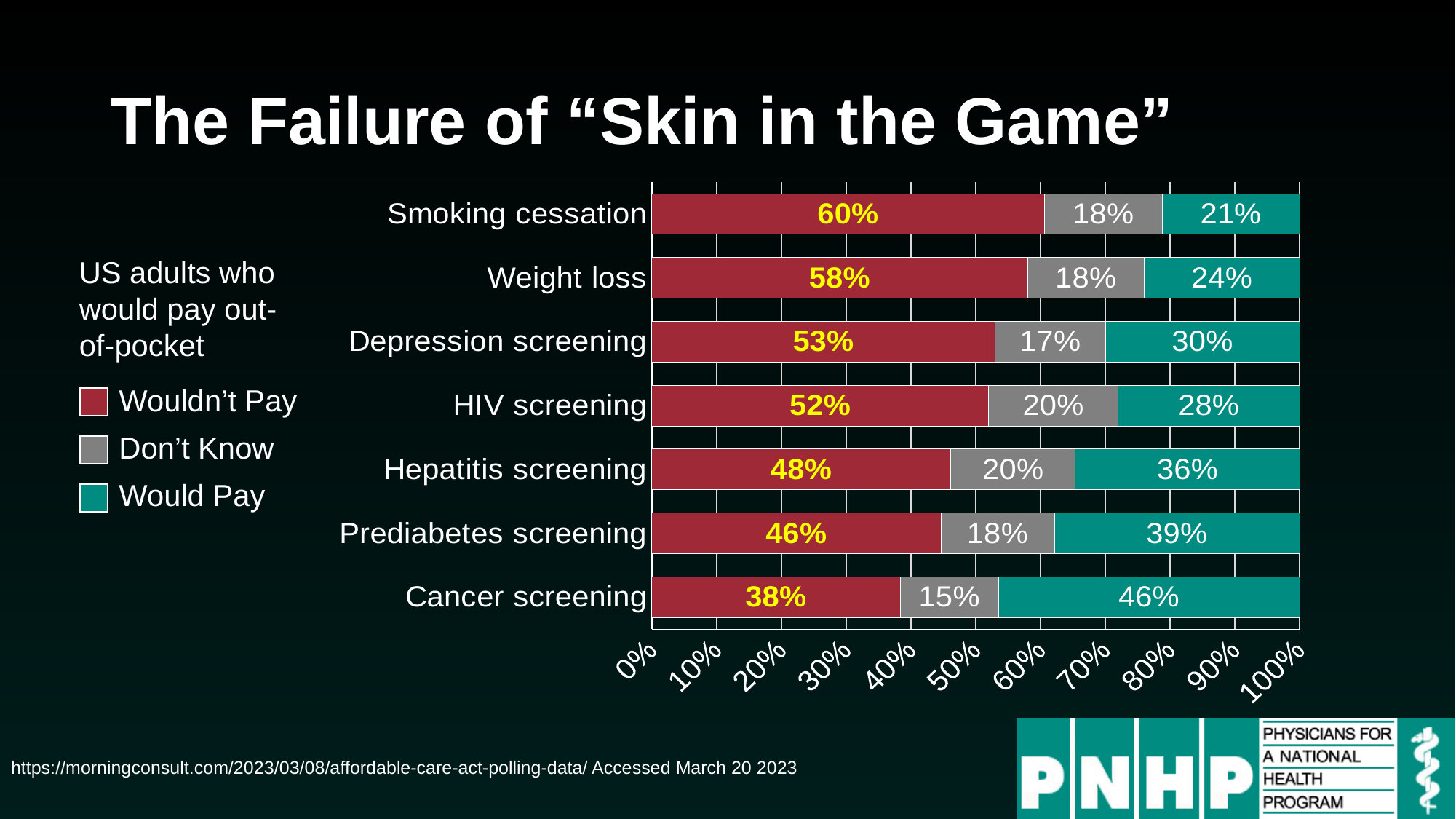
How many series does the legend list? 3 How many services are listed on the chart? 7 What kind of chart is shown on the slide? Stacked bar chart What is the difference between the Wouldn't Pay percentages for weight loss and cancer screening? 20% What percentage of US adults would pay out-of-pocket for cancer screening? 46% Which service has the lowest Would Pay percentage? Smoking cessation What percentage of US adults wouldn't pay out-of-pocket for smoking cessation? 60% What is the Don't Know percentage for HIV screening? 20% What is the total of the three segments for the prediabetes screening bar? 103% Which is larger: the Would Pay percentage for hepatitis screening or for depression screening? Hepatitis screening Which service has the highest Wouldn't Pay percentage? Smoking cessation Which colour represents the Would Pay series in the legend? Teal